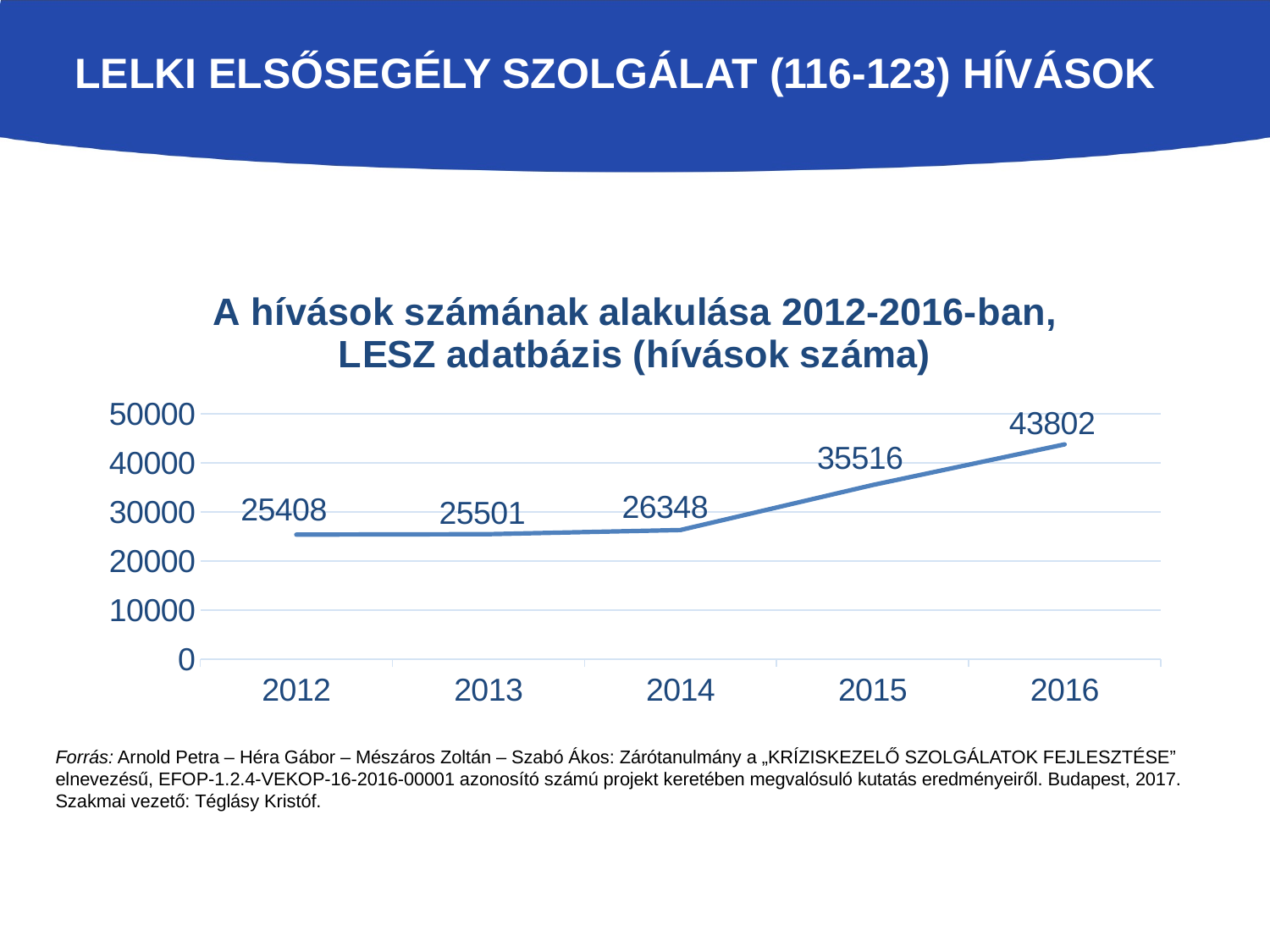
What kind of chart is shown on the slide? line chart What is the difference in the number of calls between 2014 and 2013? 847 Is the value for 2016 greater or less than 40000? greater Which year has the highest number of calls? 2016 Which year has the lowest number of calls? 2012 What is the number of calls in 2016? 43802 How many years are shown on the x axis? 5 Which year has more calls, 2014 or 2015? 2015 What is the number of calls in 2012? 25408 What is the number of calls in 2015? 35516 Do the values rise or fall from 2012 to 2016? rise What is the difference in the number of calls between 2016 and 2015? 8286